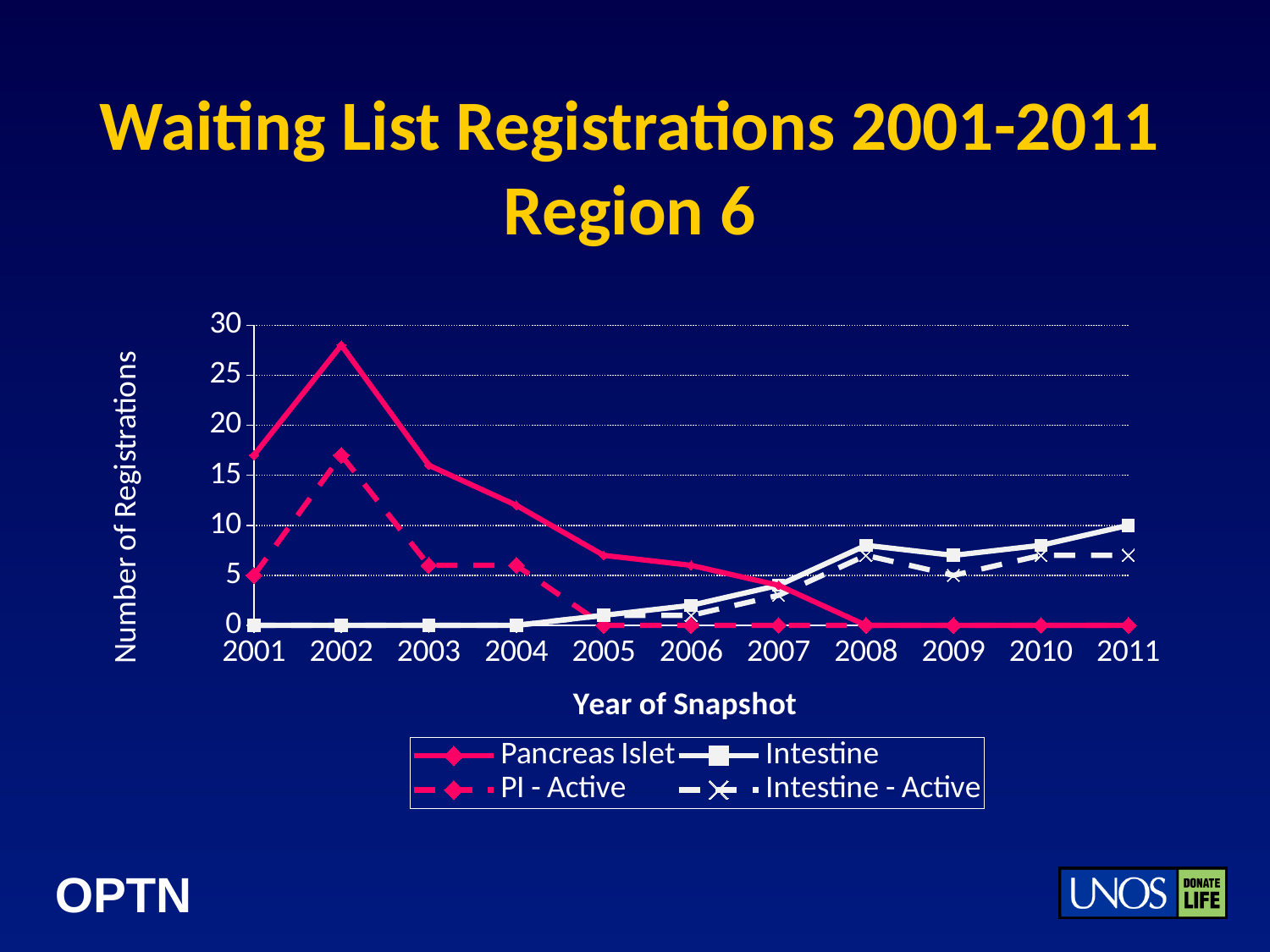
What is the Intestine value for 2001? 0 Does the Pancreas Islet series rise or fall from 2002 to 2008? fall In 2011, which is larger: the Intestine value or the Pancreas Islet value? Intestine What is the Pancreas Islet value for 2011? 0 How many years are shown on the x axis? 11 Is the Pancreas Islet value for 2002 greater or less than 25? greater Is the PI - Active value for 2002 greater or less than 15? greater What kind of chart is shown on the slide? line chart What is the title of the x axis? Year of Snapshot What is the Intestine value for 2011? 10 How many series does the legend list? 4 In which year does the Pancreas Islet series reach its highest value? 2002